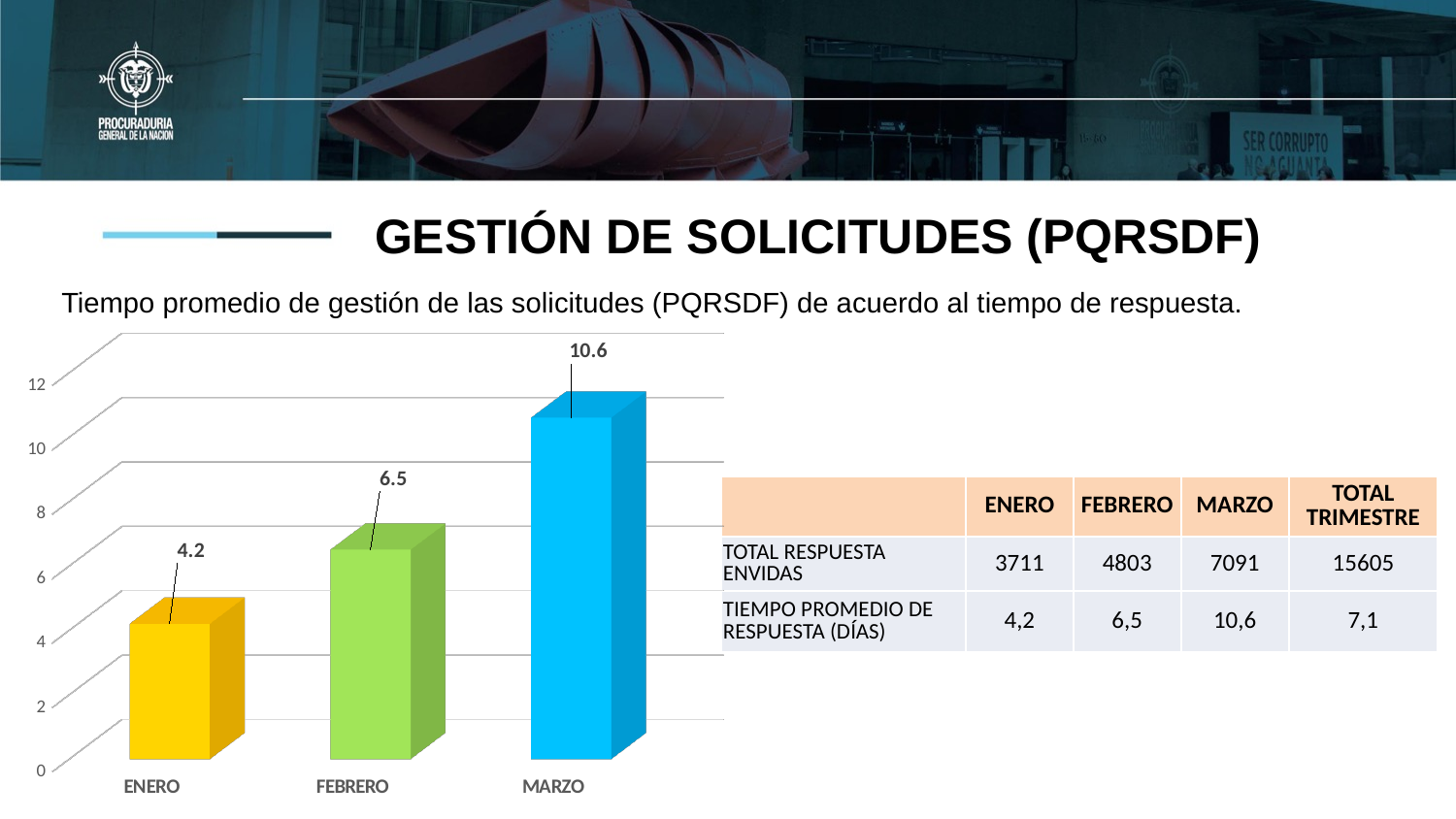
Which is larger, the value for FEBRERO or the value for MARZO? MARZO Is the value for MARZO greater or less than 10? greater Do the values rise or fall from ENERO to MARZO? rise Which month has the lowest value in the chart? ENERO What is the value shown for ENERO in the chart? 4.2 What is the difference between the values for FEBRERO and ENERO? 2.3 Which month has the highest value in the chart? MARZO What kind of chart is shown on the slide? bar chart What is the value shown for FEBRERO in the chart? 6.5 What is the value shown for MARZO in the chart? 10.6 What is the difference between the values for MARZO and ENERO? 6.4 How many months are shown in the chart? 3